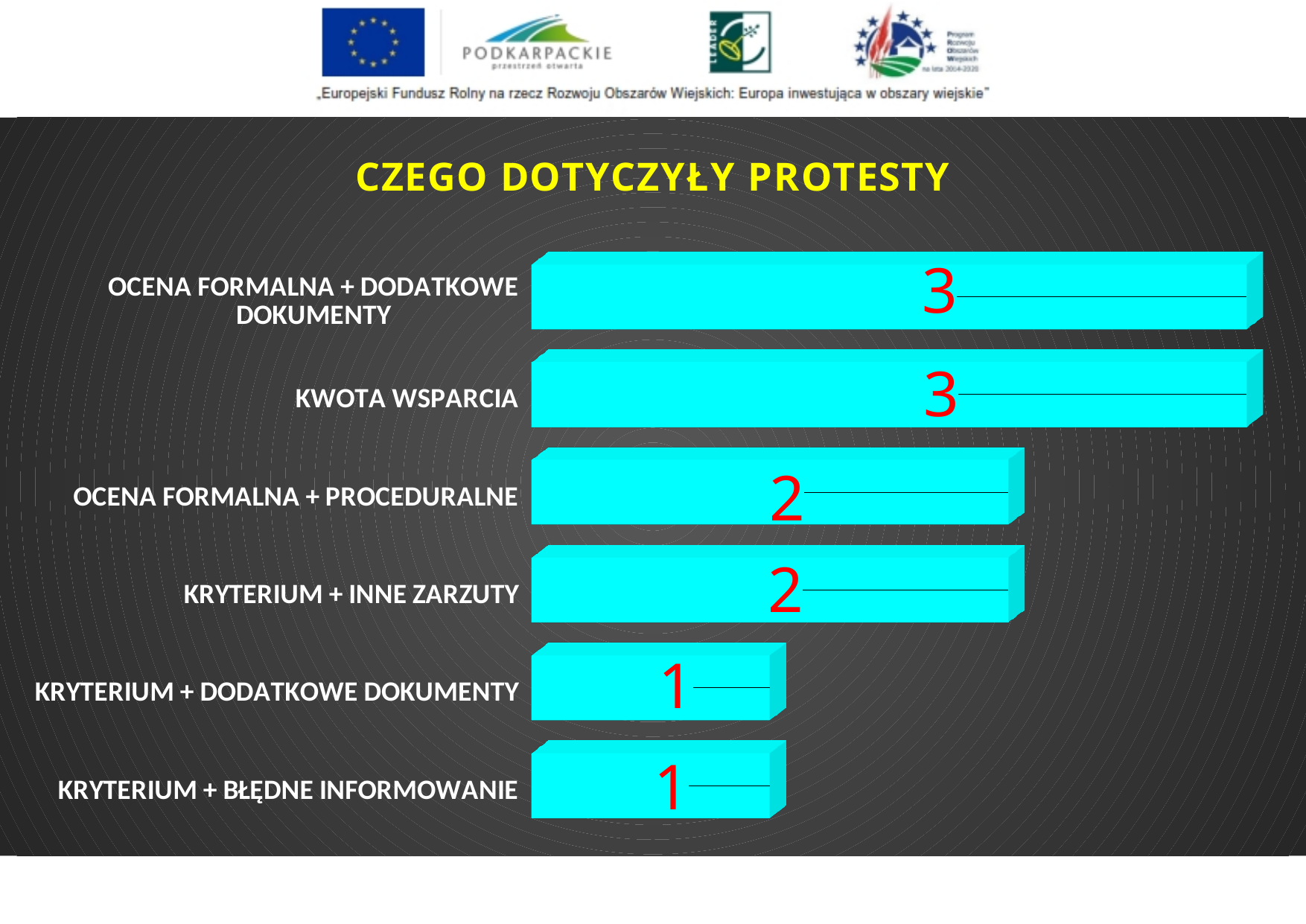
What is the title of the chart? CZEGO DOTYCZYŁY PROTESTY Which is larger, the value for KWOTA WSPARCIA or the value for KRYTERIUM + INNE ZARZUTY? KWOTA WSPARCIA What is the value for OCENA FORMALNA + PROCEDURALNE? 2 What kind of chart is shown on the slide? bar chart What is the value for KRYTERIUM + INNE ZARZUTY? 2 How many categories are shown in the chart? 6 What is the value for KRYTERIUM + BŁĘDNE INFORMOWANIE? 1 Do the values rise or fall going from the top category to the bottom category? fall What is the difference between the values for OCENA FORMALNA + DODATKOWE DOKUMENTY and KRYTERIUM + DODATKOWE DOKUMENTY? 2 What is the difference between the values for KRYTERIUM + INNE ZARZUTY and KRYTERIUM + BŁĘDNE INFORMOWANIE? 1 What colour are the bars in the chart? cyan What is the value for KWOTA WSPARCIA? 3